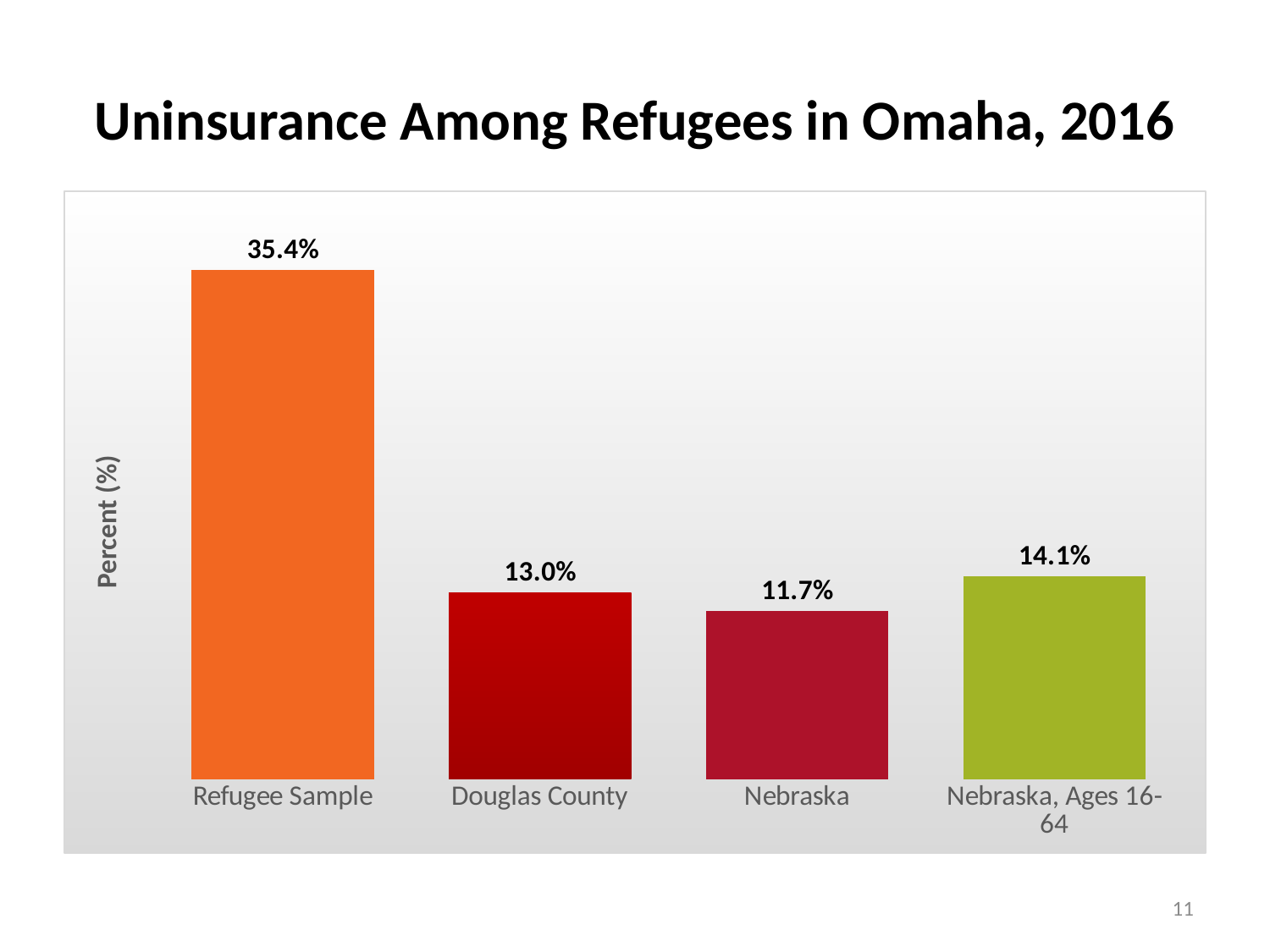
What kind of chart is shown on the slide? Bar chart What is the uninsurance rate for Nebraska, Ages 16-64? 14.1% What is the title of the chart on the slide? Uninsurance Among Refugees in Omaha, 2016 What is the uninsurance rate for Douglas County? 13.0% Which category has the lowest uninsurance rate? Nebraska How many categories are shown in the chart? 4 What is the difference in uninsurance rate between Nebraska, Ages 16-64 and Nebraska? 2.4% What is the uninsurance rate for the Refugee Sample? 35.4% What is the uninsurance rate for Nebraska? 11.7% What is the difference in uninsurance rate between the Refugee Sample and Douglas County? 22.4% Which has a higher uninsurance rate, Douglas County or Nebraska, Ages 16-64? Nebraska, Ages 16-64 Which category has the highest uninsurance rate? Refugee Sample